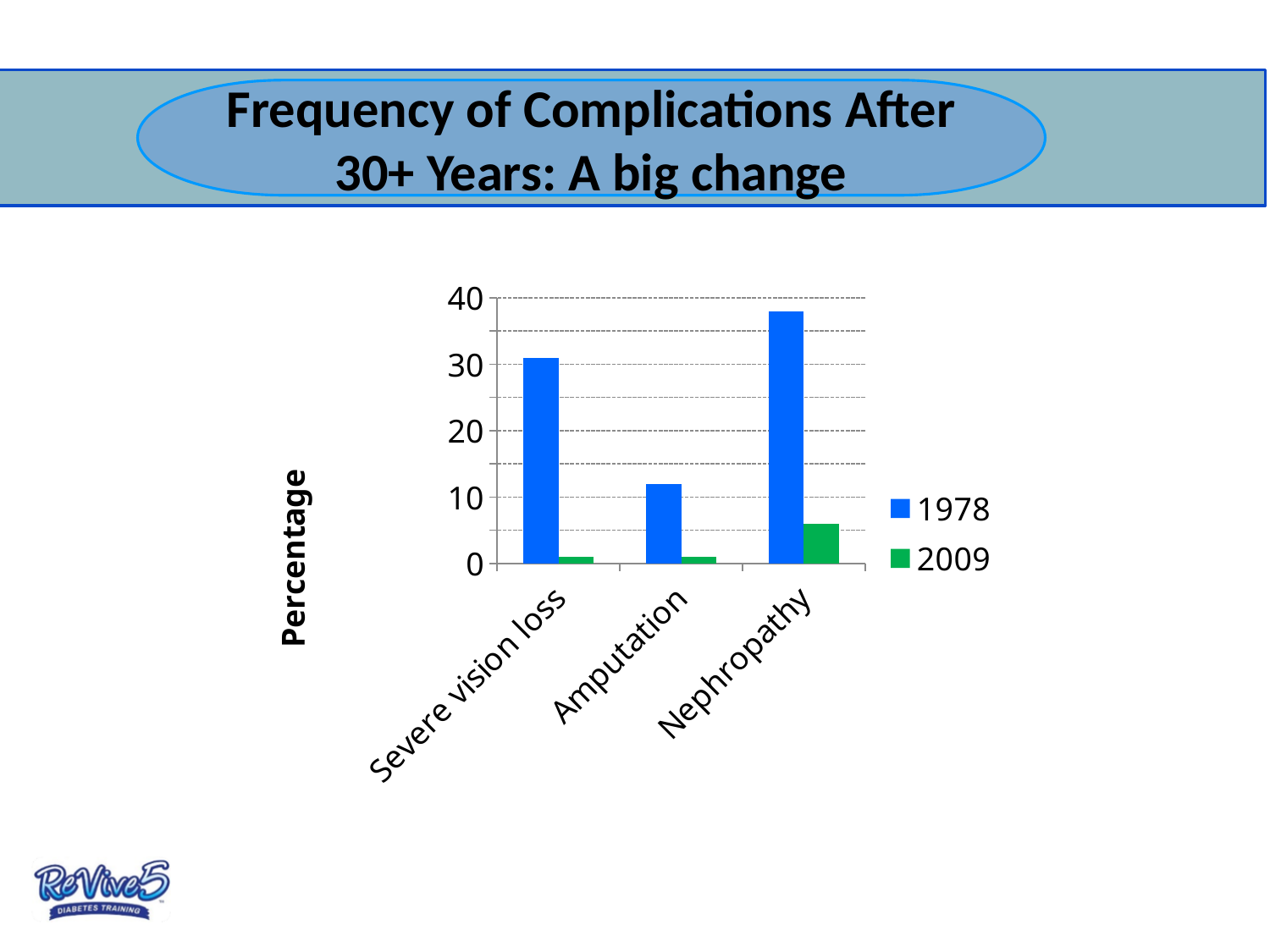
What kind of chart is shown on the slide? bar chart Is the 1978 value for Nephropathy greater or less than 30? greater Which category has the highest value for 1978? Nephropathy For Nephropathy, which series has the larger value, 1978 or 2009? 1978 Which category has the lowest value for 1978? Amputation Is the 1978 value for Amputation greater or less than 20? less Is the 2009 value for Nephropathy greater or less than 10? less Which category has the highest value for 2009? Nephropathy What is the label on the vertical axis? Percentage How many series does the legend list? 2 How many categories are shown on the x axis? 3